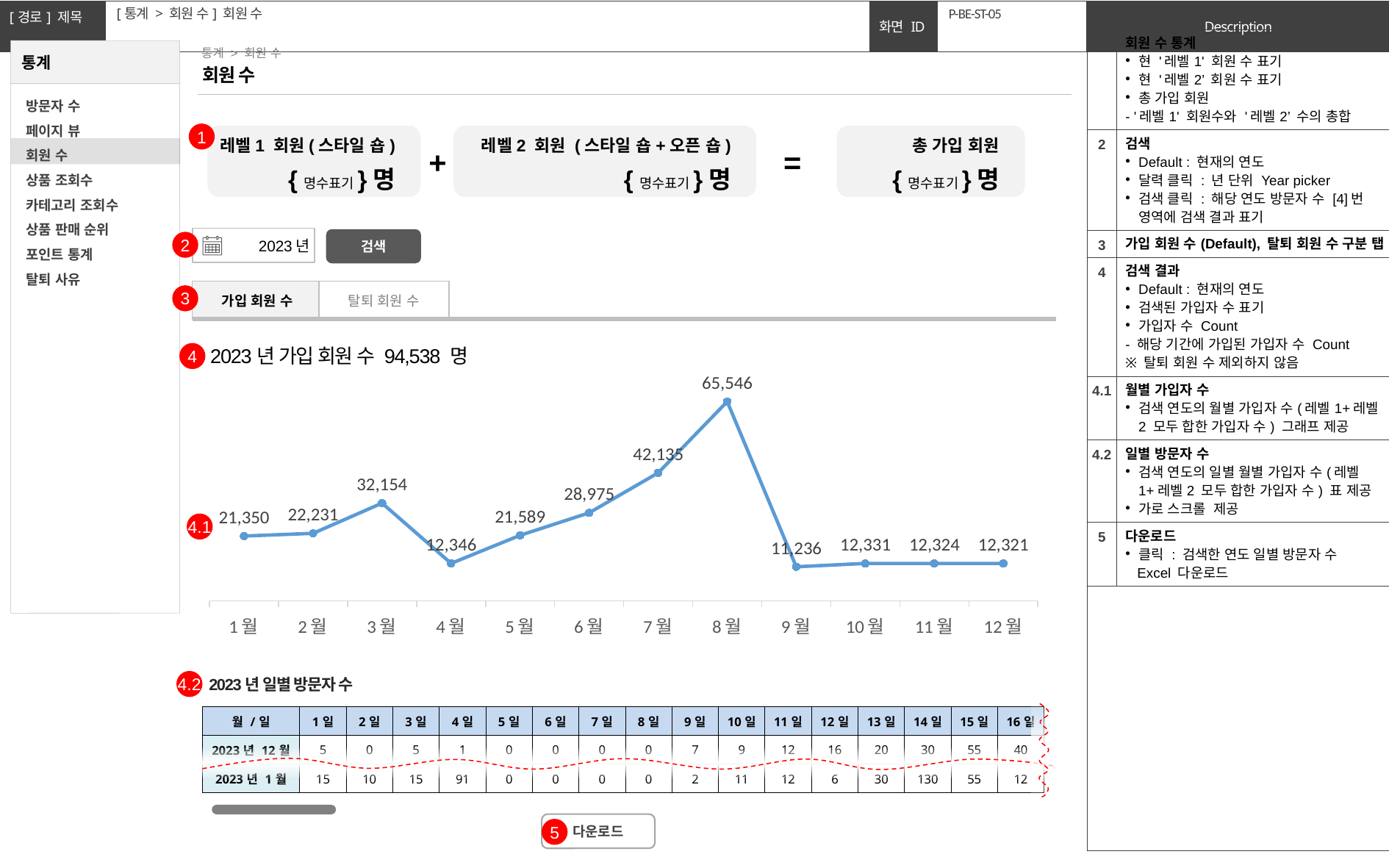
Do the values rise or fall from 8월 to 9월 in the line chart? fall What is the difference between the values for 8월 and 7월 in the line chart? 23,411 What type of chart is shown on the slide? line chart What total number of members is stated in the chart heading for 2023? 94,538 명 What is the value for 7월 in the line chart? 42,135 What is the value for 4월 in the line chart? 12,346 How many months are plotted on the x axis of the line chart? 12 What is the value for 1월 in the line chart? 21,350 Which month has the highest value in the line chart? 8월 Which is larger in the line chart, the value for 3월 or the value for 6월? 3월 Which month has the lowest value in the line chart? 9월 What is the value for 8월 in the line chart? 65,546